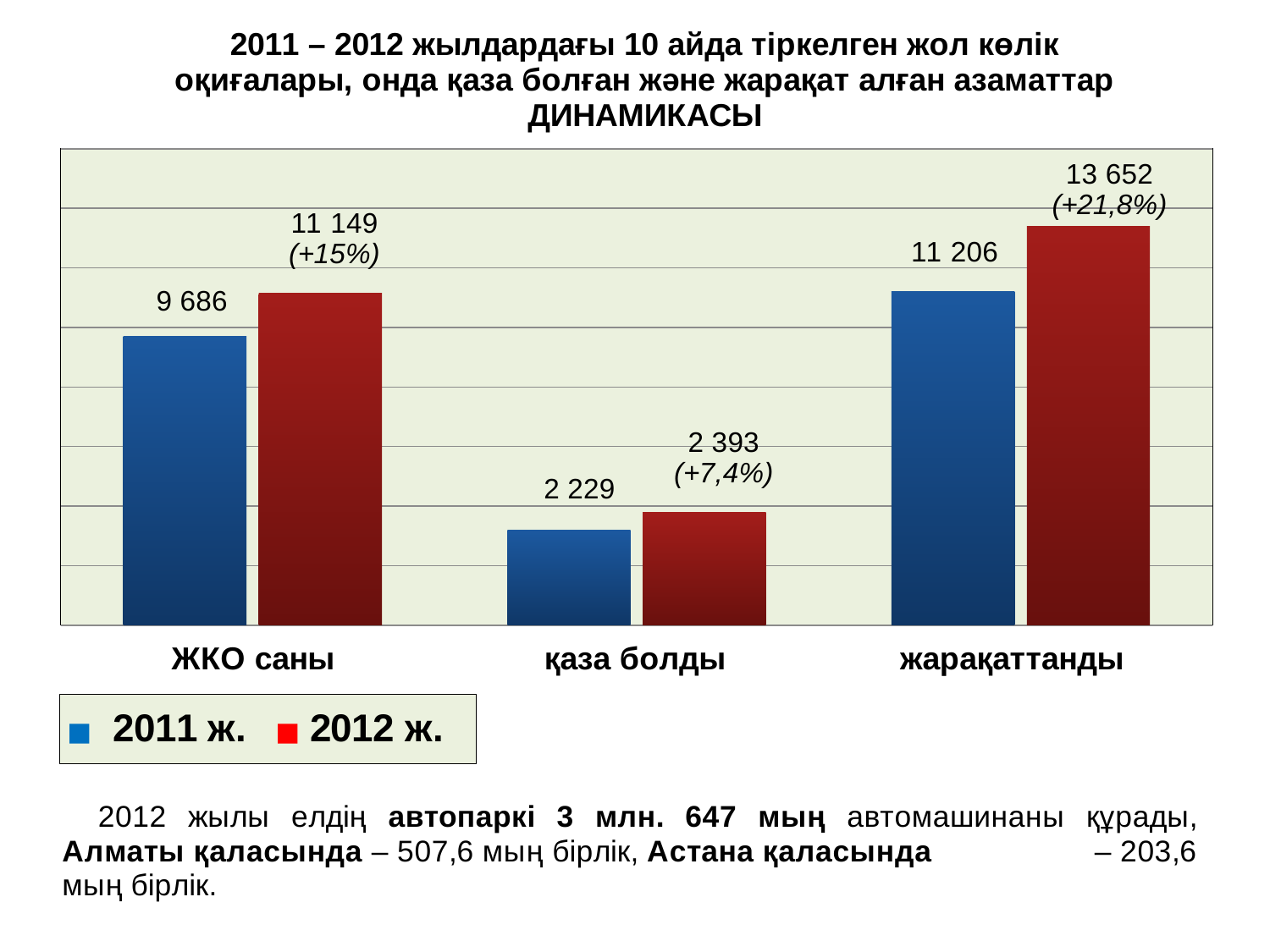
Which category has the highest 2012 ж. value? жарақаттанды What kind of chart is shown on the slide? bar chart How many series does the legend list? 2 What is the value for 2011 ж. in the ЖКО саны category? 9 686 Which category has the lowest 2011 ж. value? қаза болды What percentage change is shown next to the 2012 ж. value for жарақаттанды? +21,8% Which is larger for жарақаттанды: the 2011 ж. value or the 2012 ж. value? 2012 ж. What is the value for 2011 ж. in the қаза болды category? 2 229 What is the value for 2012 ж. in the жарақаттанды category? 13 652 What is the value for 2012 ж. in the ЖКО саны category? 11 149 How many categories are shown on the x axis? 3 What is the difference between the 2012 ж. and 2011 ж. values for қаза болды? 164